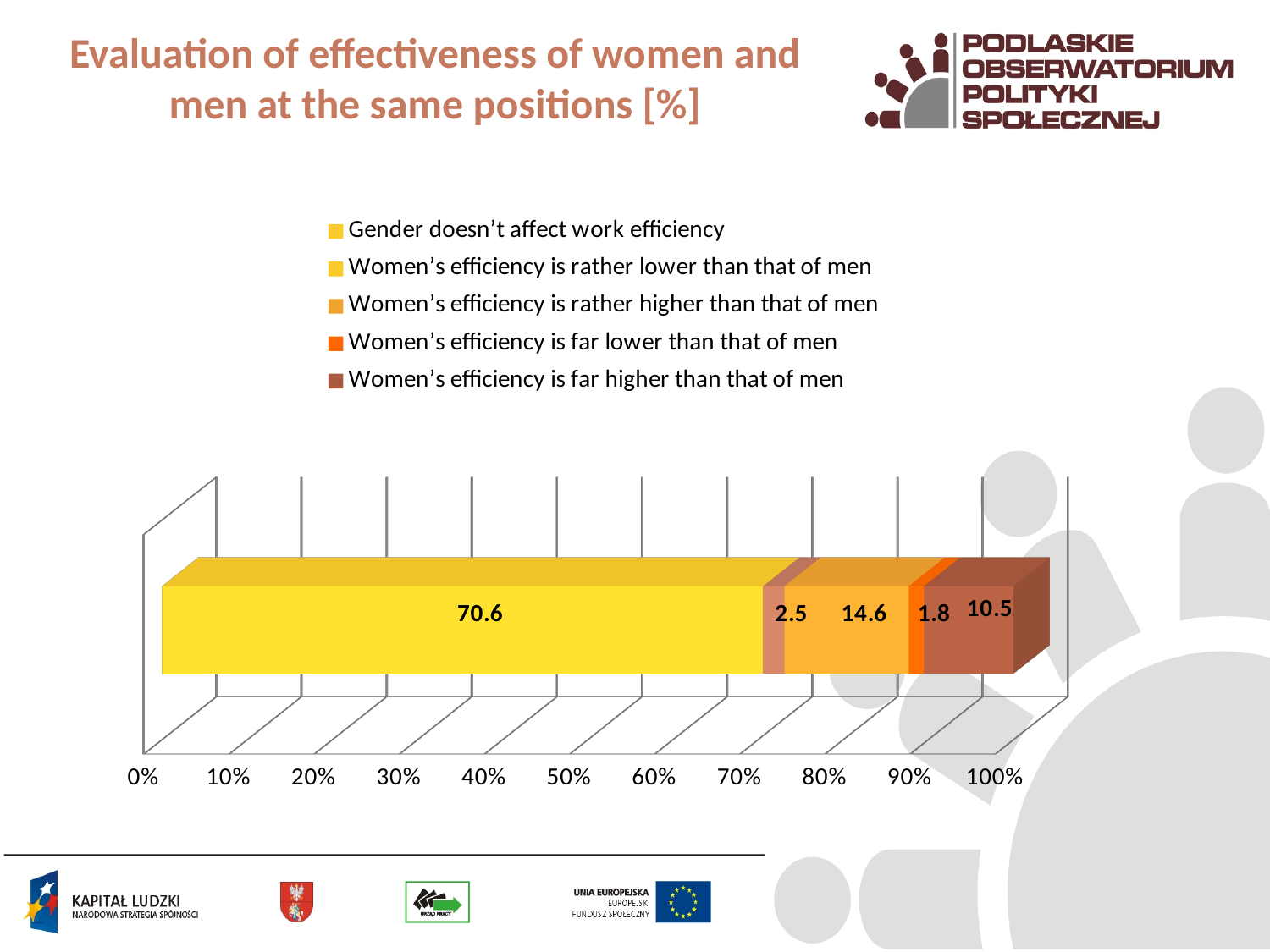
What is the value for 'Gender doesn't affect work efficiency'? 70.6 What is the value for 'Women's efficiency is rather higher than that of men'? 14.6 What is the value for 'Women's efficiency is far lower than that of men'? 1.8 What is the total of all segments in the stacked bar? 100.0 What is the value for 'Women's efficiency is far higher than that of men'? 10.5 What is the value for 'Women's efficiency is rather lower than that of men'? 2.5 Which legend category has the lowest value? Women's efficiency is far lower than that of men What is the difference between the values for 'Women's efficiency is rather higher than that of men' and 'Women's efficiency is far higher than that of men'? 4.1 What kind of chart is shown on the slide? stacked bar chart Which legend category has the highest value? Gender doesn't affect work efficiency How many series does the legend list? 5 Which is larger: the value for 'Women's efficiency is rather lower than that of men' or 'Women's efficiency is far lower than that of men'? Women's efficiency is rather lower than that of men